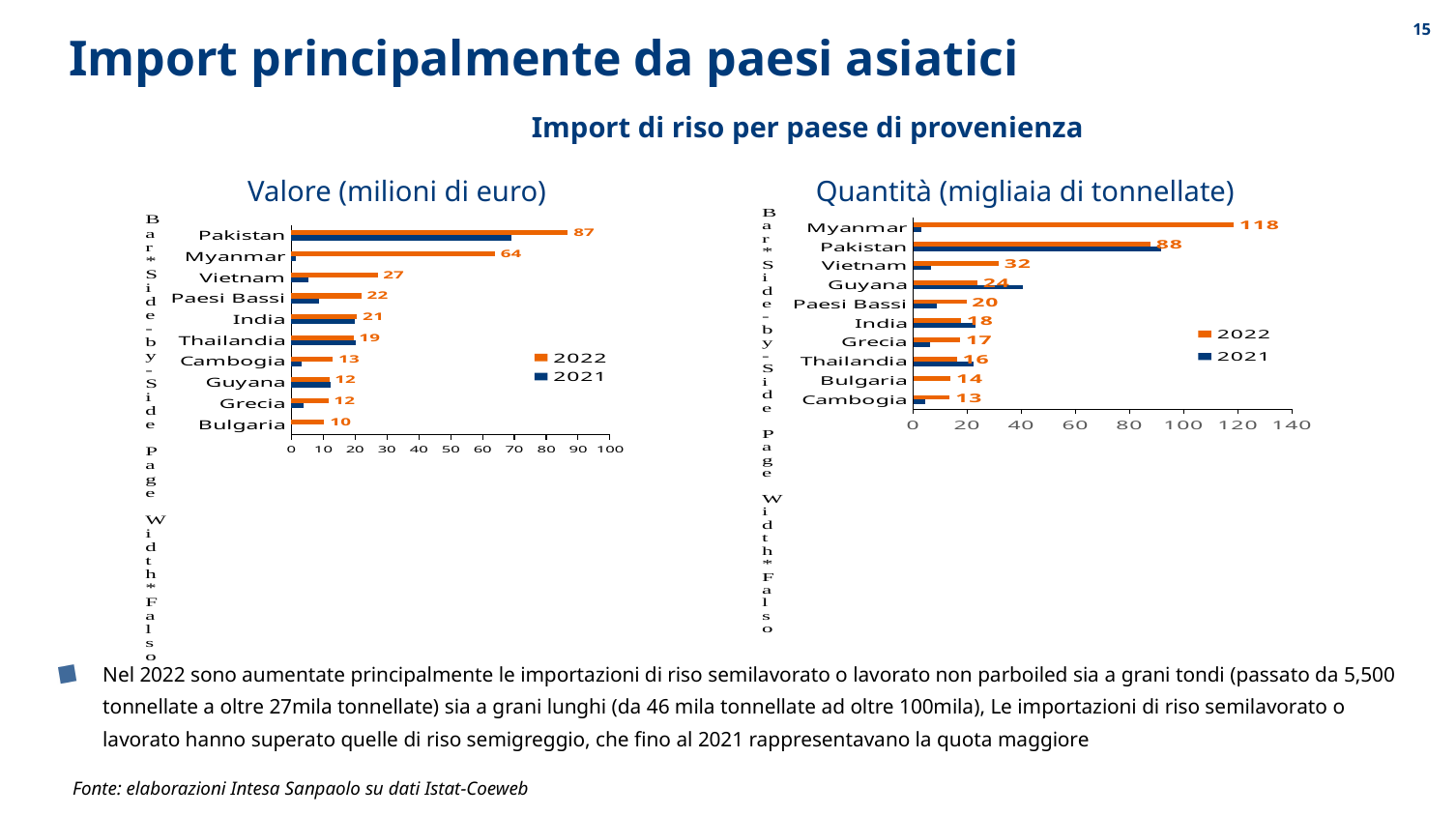
How many series does the legend of the 'Quantità (migliaia di tonnellate)' chart list? 2 In the 'Quantità (migliaia di tonnellate)' chart, what is the 2022 value for Paesi Bassi? 20 How many countries are shown in the 'Valore (milioni di euro)' chart? 10 In the 'Quantità (migliaia di tonnellate)' chart, what is the 2022 value for Myanmar? 118 In the 'Quantità (migliaia di tonnellate)' chart, is the 2021 value for Myanmar greater or less than 20? less What type of chart is the 'Valore (milioni di euro)' chart? Bar chart In the 'Quantità (migliaia di tonnellate)' chart, which has the larger 2022 value, Vietnam or Guyana? Vietnam In the 'Valore (milioni di euro)' chart, what is the 2022 value for Pakistan? 87 In the 'Valore (milioni di euro)' chart, what is the difference between the 2022 values for Pakistan and Myanmar? 23 In the 'Valore (milioni di euro)' chart, is the 2021 value for Pakistan greater or less than 60? greater In the 'Quantità (migliaia di tonnellate)' chart, which country has the lowest 2022 value? Cambogia In the 'Valore (milioni di euro)' chart, which country has the highest 2022 value? Pakistan